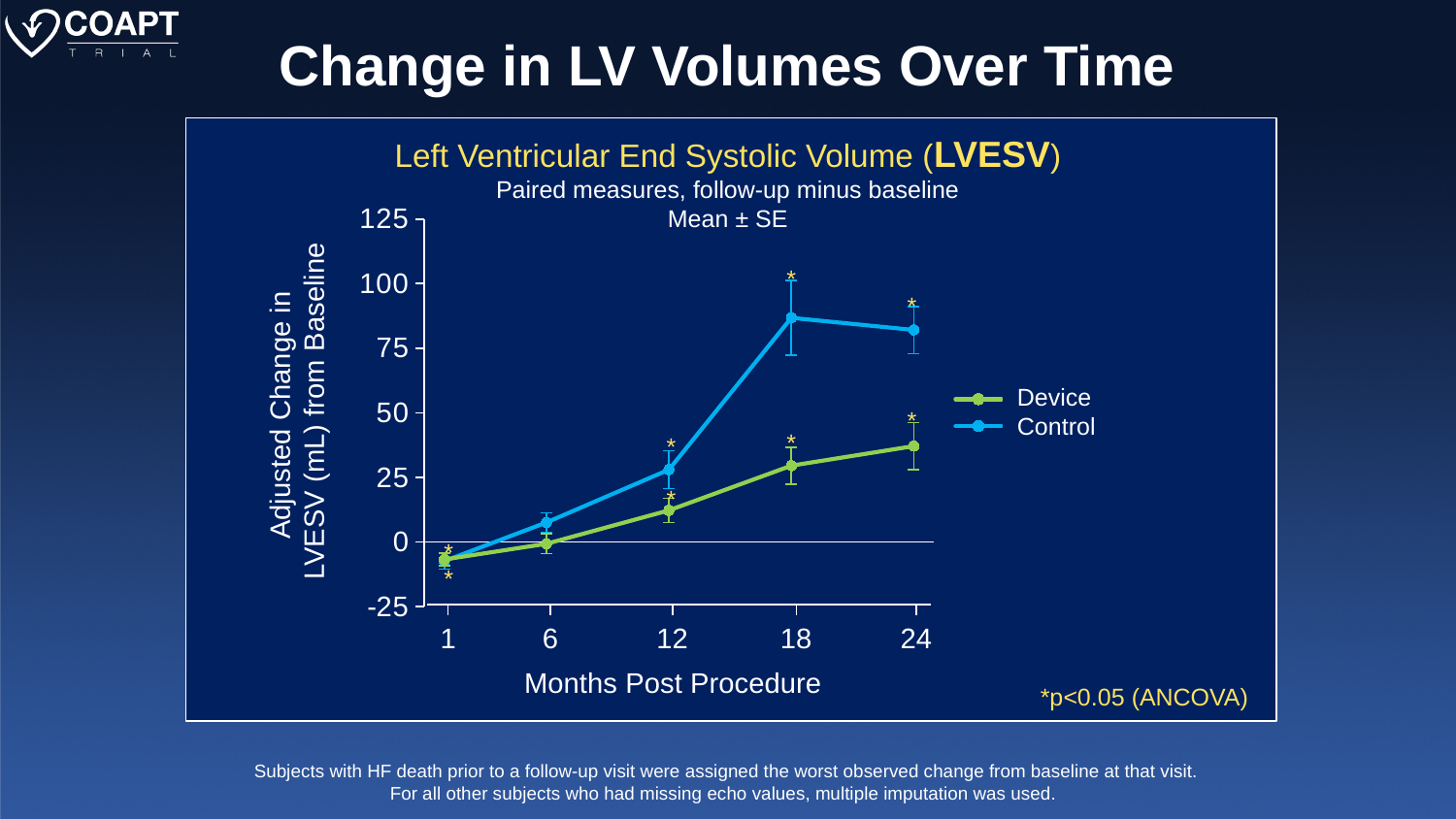
Is the Control value at 12 months greater or less than 50? less Is the Control value at 18 months greater or less than 75? greater Do the Device values rise or fall from 1 month to 24 months? rise At which month is the Device series at its highest value? 24 Is the Device value at 12 months greater or less than 25? less What is the title of the x axis? Months Post Procedure How many series does the legend list? 2 How many time points are plotted along the x axis? 5 What colour is the Control line? blue At 18 months, which series has the larger adjusted change in LVESV, Device or Control? Control What kind of chart is shown on the slide? line chart